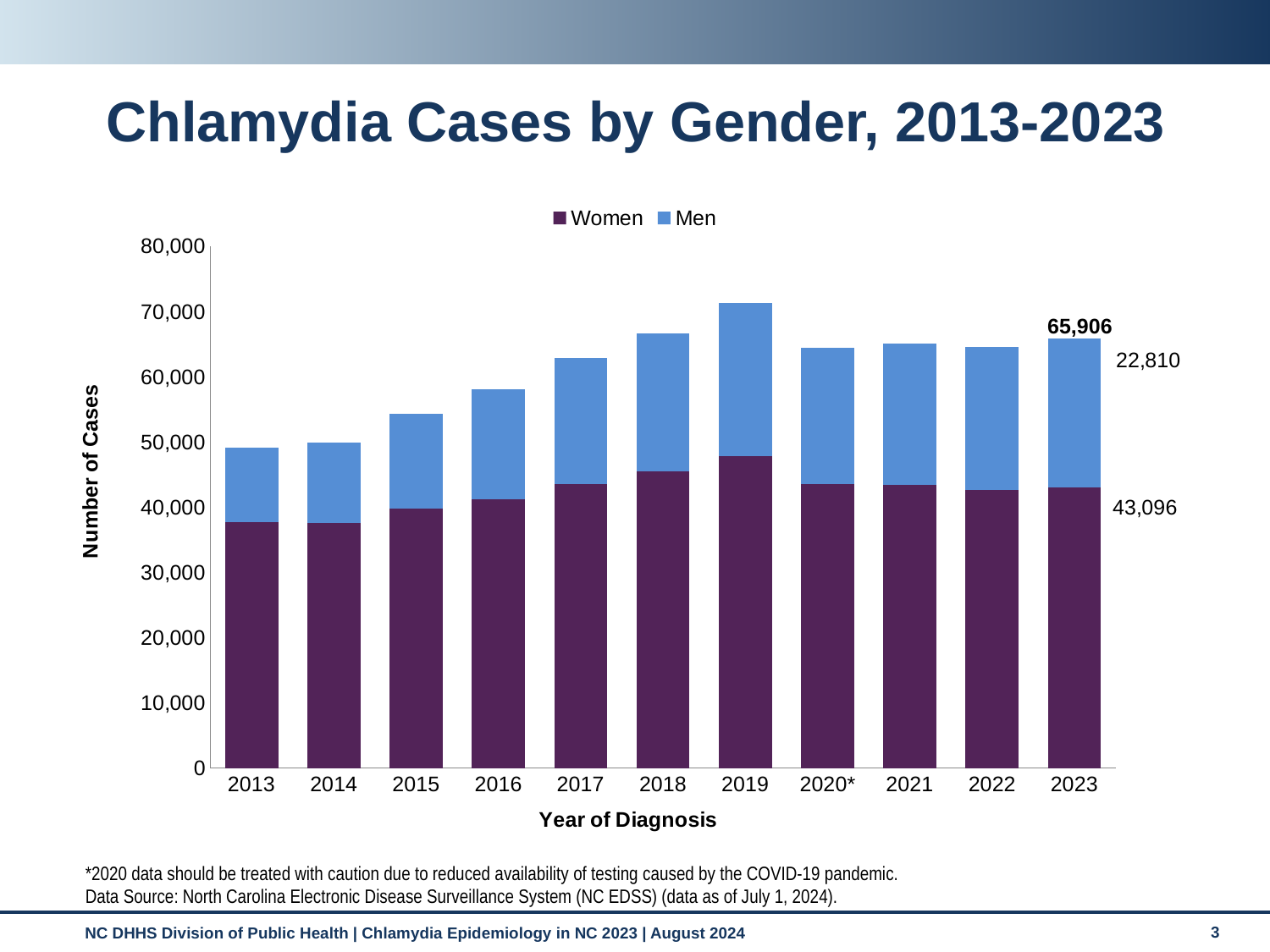
How many chlamydia cases among women were reported in 2023? 43,096 How many series does the legend list? 2 What kind of chart is shown on the slide? Stacked bar chart Which year has the highest total number of chlamydia cases? 2019 In 2023, how many more cases were reported among women than among men? 20,286 Is the total number of cases in 2015 greater or less than 60,000? less How many chlamydia cases among men were reported in 2023? 22,810 What is the total number of chlamydia cases shown for 2023? 65,906 Is the total number of cases in 2019 greater or less than 70,000? greater In 2023, which group had more cases, women or men? Women Do the total number of cases rise or fall from 2013 to 2019? rise How many years are shown on the x axis of the chart? 11